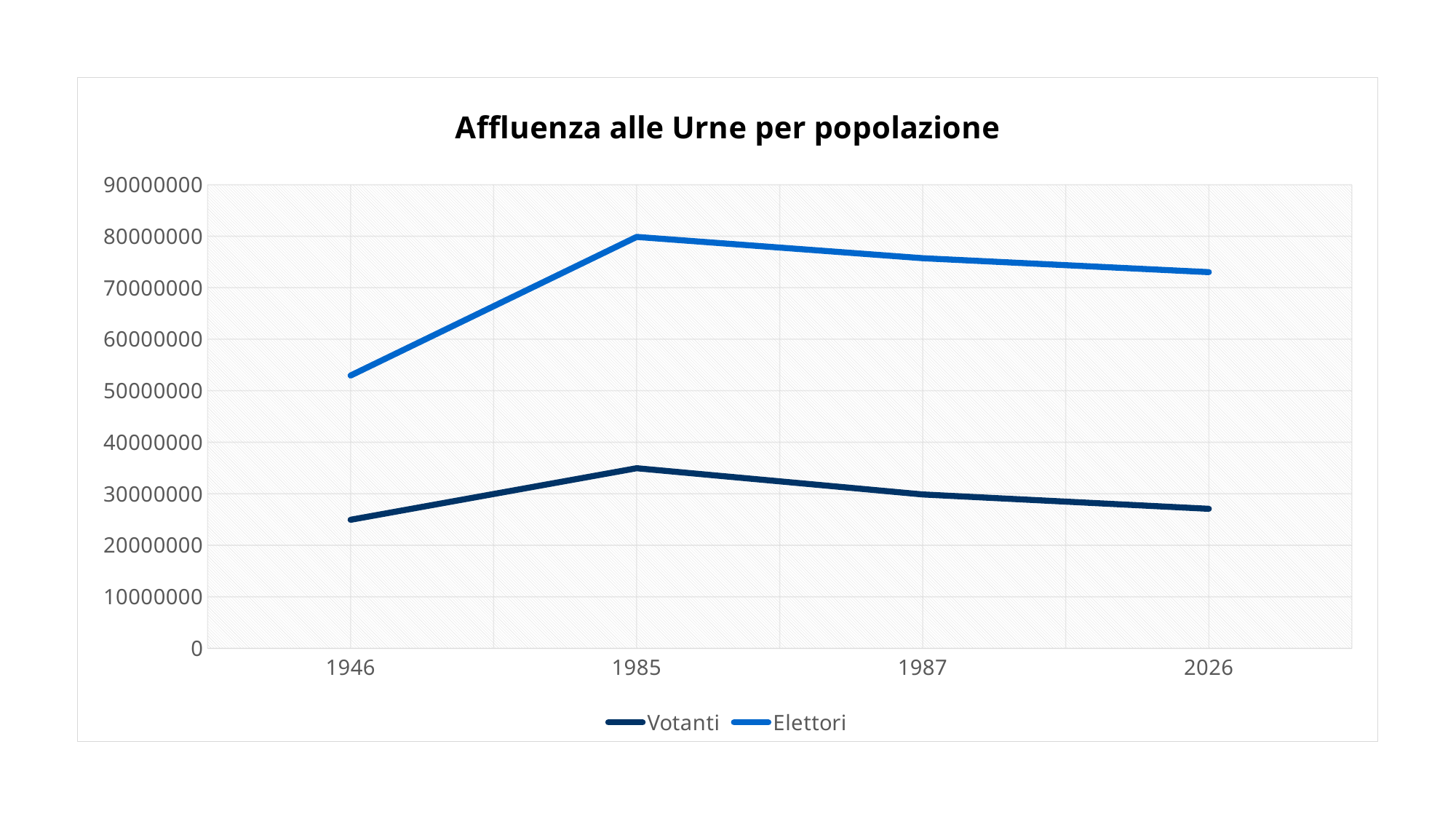
In which year is the Votanti series lowest? 1946 Do the Votanti values rise or fall from 1985 to 2026? fall What is the title of the chart? Affluenza alle Urne per popolazione What kind of chart is shown on the slide? line chart Is the value for Votanti in 1946 greater or less than 30000000? less How many years are shown on the x axis? 4 How many series does the legend list? 2 Which series has the larger value in 1987, Votanti or Elettori? Elettori